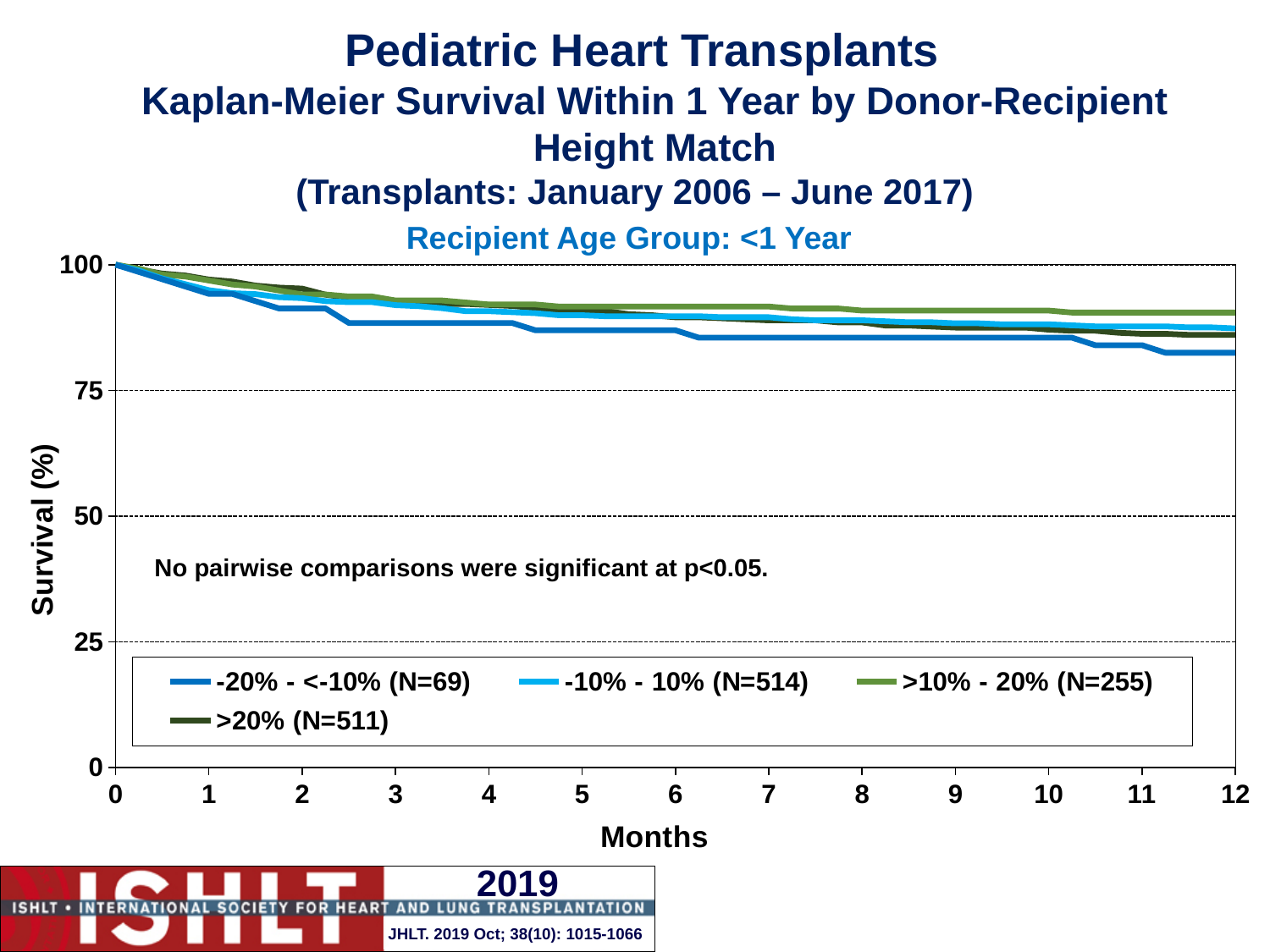
Is the survival for the >20% group at 12 months greater or less than 100? less Do the survival curves rise or fall as months increase? fall What is the N for the -10% - 10% group in the legend? 514 What is the survival (%) for all groups at 0 months? 100 Is the survival for the -20% - <-10% group at 12 months greater or less than 75? greater What recipient age group does the chart cover? <1 Year What is the maximum value shown on the Months axis? 12 What kind of chart is shown on the slide? line chart Which height-match group has the lowest survival at 12 months? -20% - <-10% (N=69) How many series does the legend list? 4 Which height-match group has the highest survival at 12 months? >10% - 20% (N=255) At 12 months, which is larger: survival for the >10% - 20% group or the -20% - <-10% group? >10% - 20% group